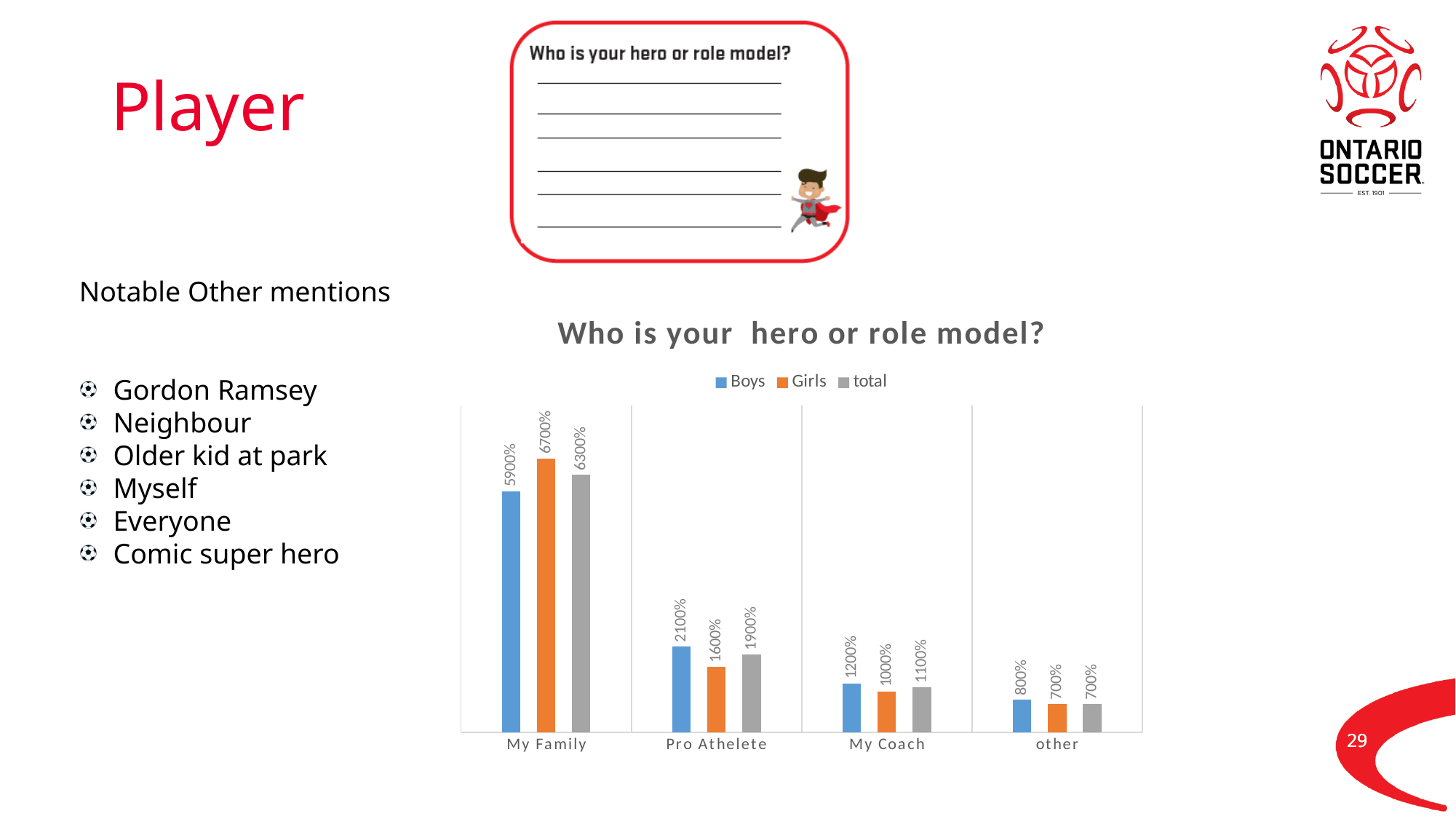
What is the difference between the Girls and Boys values for My Family? 800% What is the Girls value for other? 700% What is the Boys value for My Family? 5900% What is the total value for My Coach? 1100% Which category has the highest Girls value? My Family How many series does the legend list? 3 What is the title of the chart? Who is your hero or role model? What kind of chart is shown? bar chart Which category has the lowest Boys value? other What is the Girls value for Pro Athelete? 1600% How many categories are shown on the x axis? 4 Which is larger for Pro Athelete, the Boys value or the Girls value? Boys